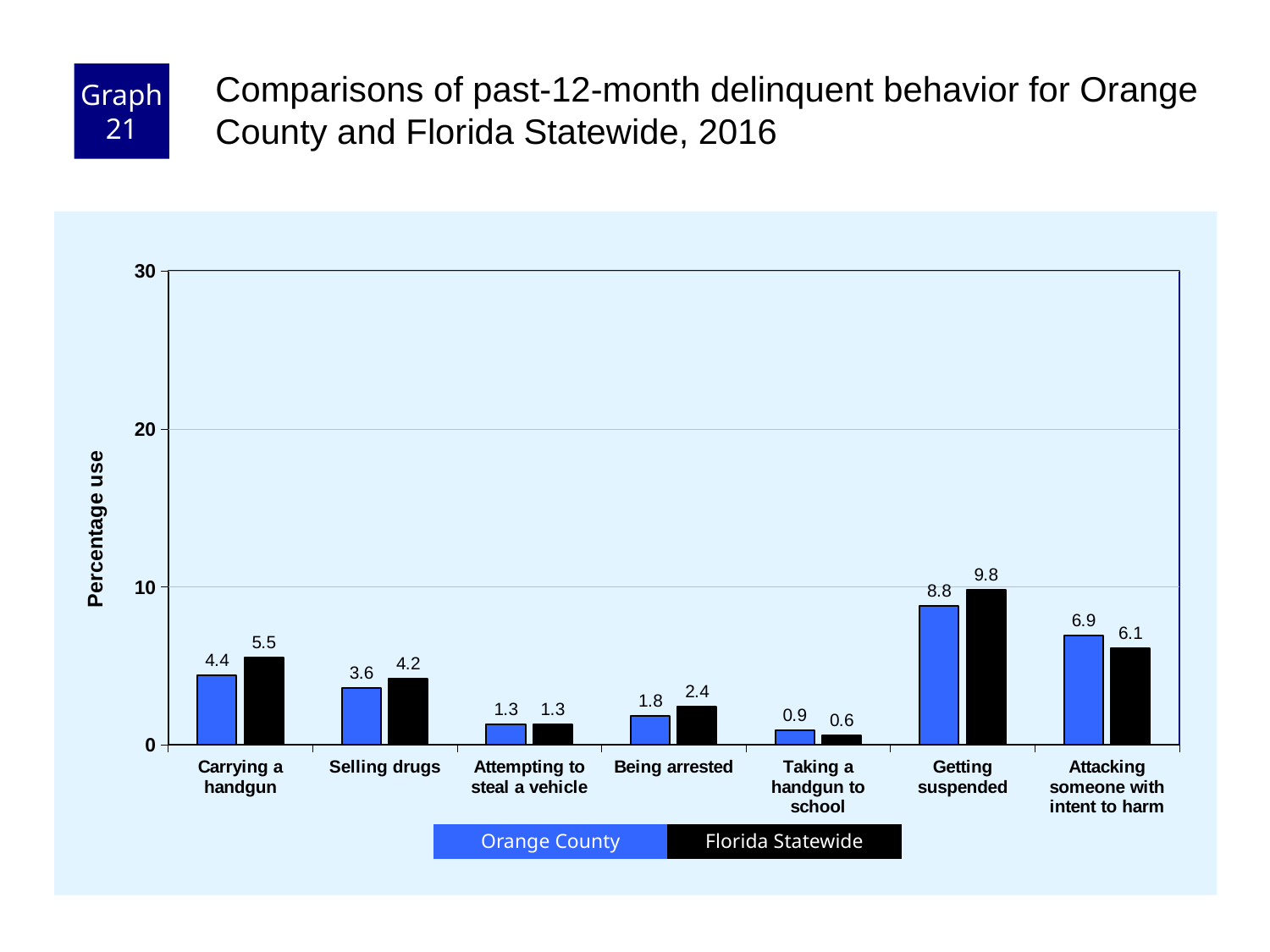
How many series does the legend list? 2 For Attacking someone with intent to harm, which is larger: Orange County or Florida Statewide? Orange County What is the Orange County value for Getting suspended? 8.8 What is the Florida Statewide value for Carrying a handgun? 5.5 What kind of chart is shown on the slide? bar chart How many behavior categories are shown on the x axis? 7 What is the difference between the Florida Statewide and Orange County values for Getting suspended? 1.0 Which category has the highest Florida Statewide value? Getting suspended Which category has the lowest Orange County value? Taking a handgun to school Is the Florida Statewide value for Getting suspended greater or less than 10? less What is the label of the y axis? Percentage use What is the Orange County value for Taking a handgun to school? 0.9